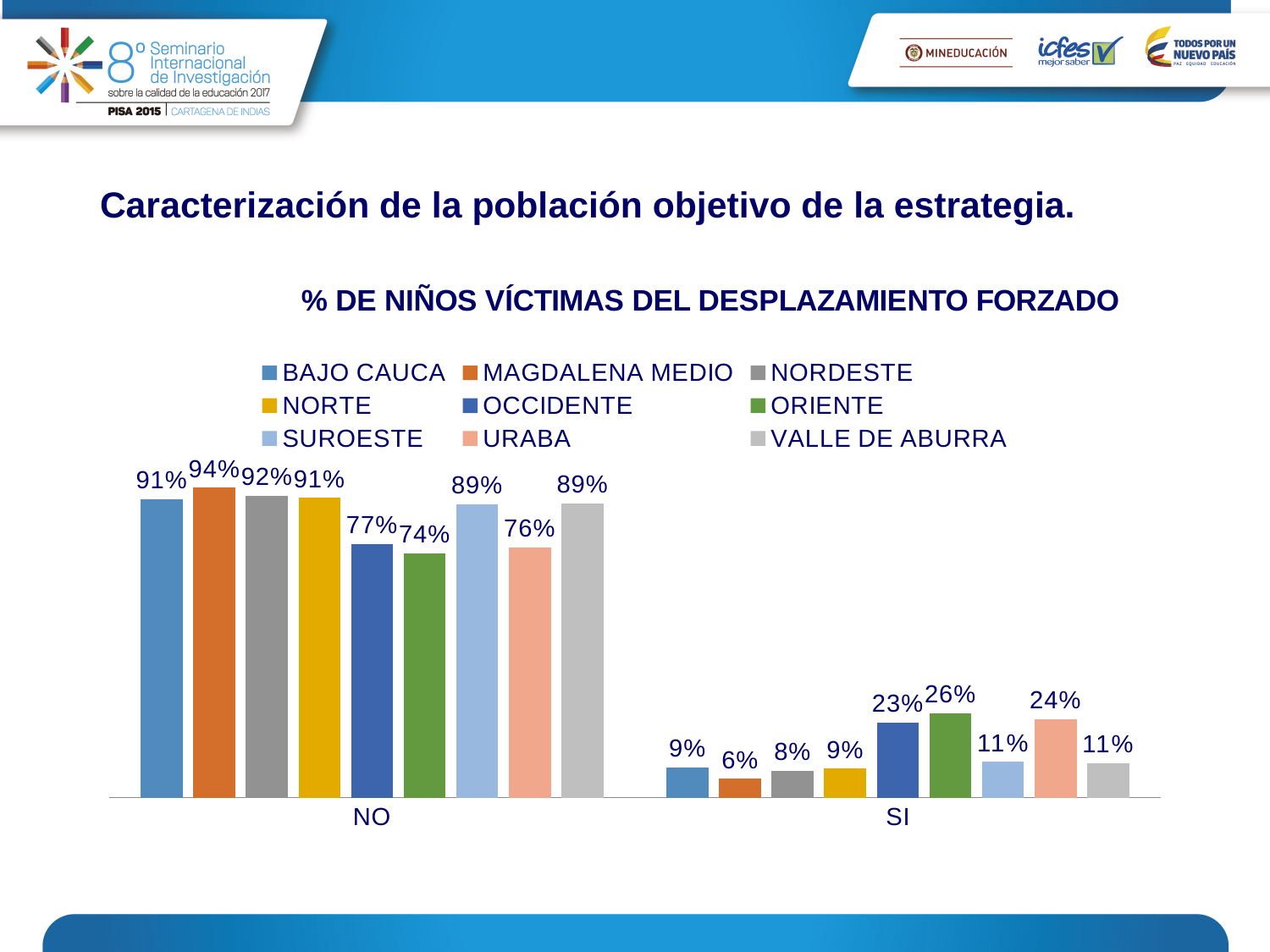
What is the difference between the OCCIDENTE and ORIENTE values in the NO category? 3% How many series does the legend list? 9 Which series has the highest value in the SI category? ORIENTE What is the value for URABA in the SI category? 24% What is the value for MAGDALENA MEDIO in the NO category? 94% Which is larger in the SI category: OCCIDENTE or SUROESTE? OCCIDENTE Which series has the lowest value in the SI category? MAGDALENA MEDIO How many categories are shown on the x axis? 2 Which series has the lowest value in the NO category? ORIENTE What kind of chart is shown on the slide? Bar chart What is the value for ORIENTE in the SI category? 26% What is the title of the chart? % DE NIÑOS VÍCTIMAS DEL DESPLAZAMIENTO FORZADO